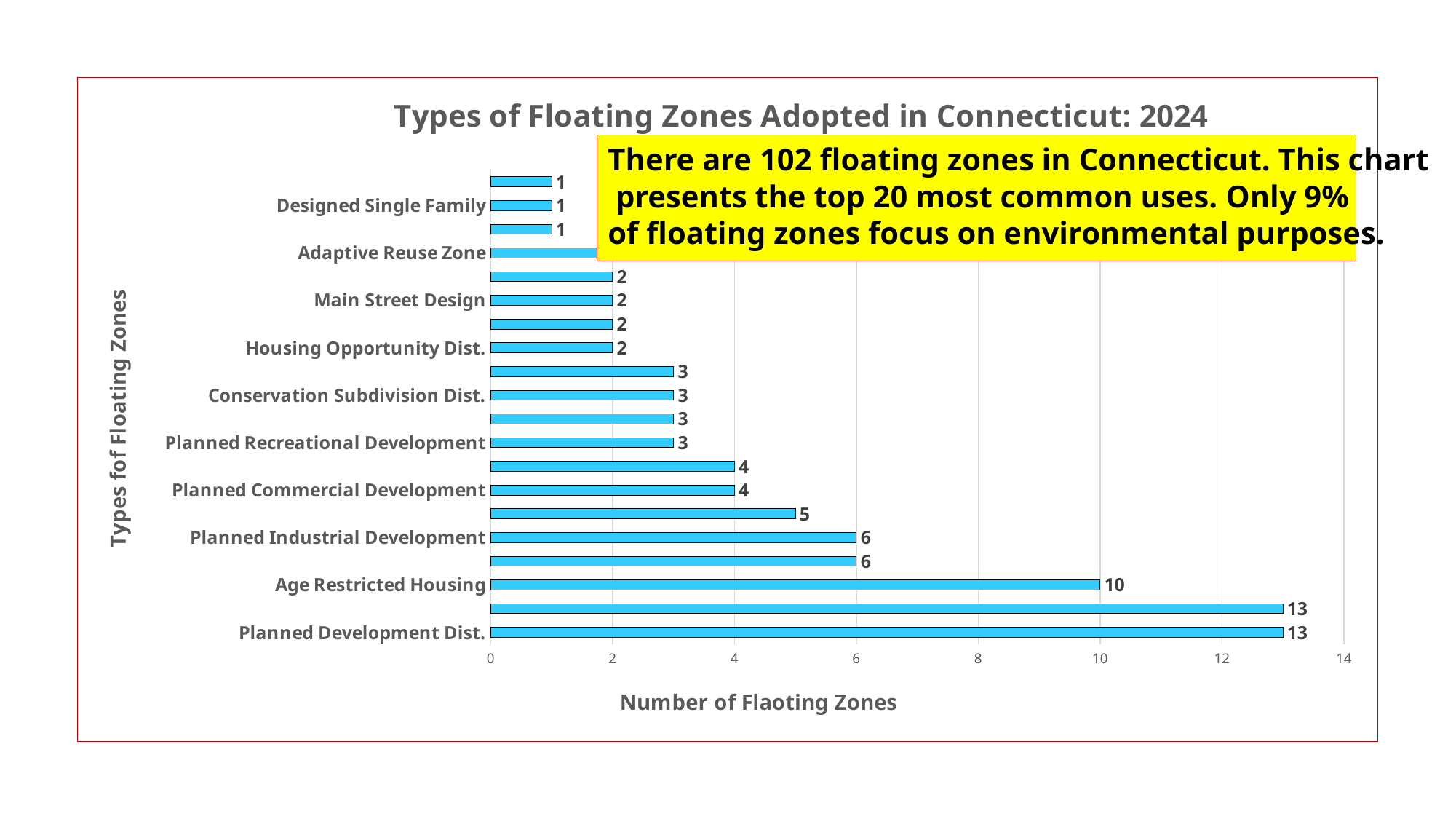
What is the number of floating zones for Designed Single Family? 1 What is the number of floating zones for Planned Industrial Development? 6 What kind of chart is shown on the slide? Bar chart Is the value for Adaptive Reuse Zone greater or less than 4? less What is the title of the chart? Types of Floating Zones Adopted in Connecticut: 2024 What is the number of floating zones for Planned Development Dist.? 13 What is the difference between the number of floating zones for Age Restricted Housing and Planned Industrial Development? 4 What is the number of floating zones for Conservation Subdivision Dist.? 3 How many bars are plotted in the chart? 20 What is the number of floating zones for Planned Commercial Development? 4 Which has more floating zones, Planned Recreational Development or Main Street Design? Planned Recreational Development What is the number of floating zones for Age Restricted Housing? 10